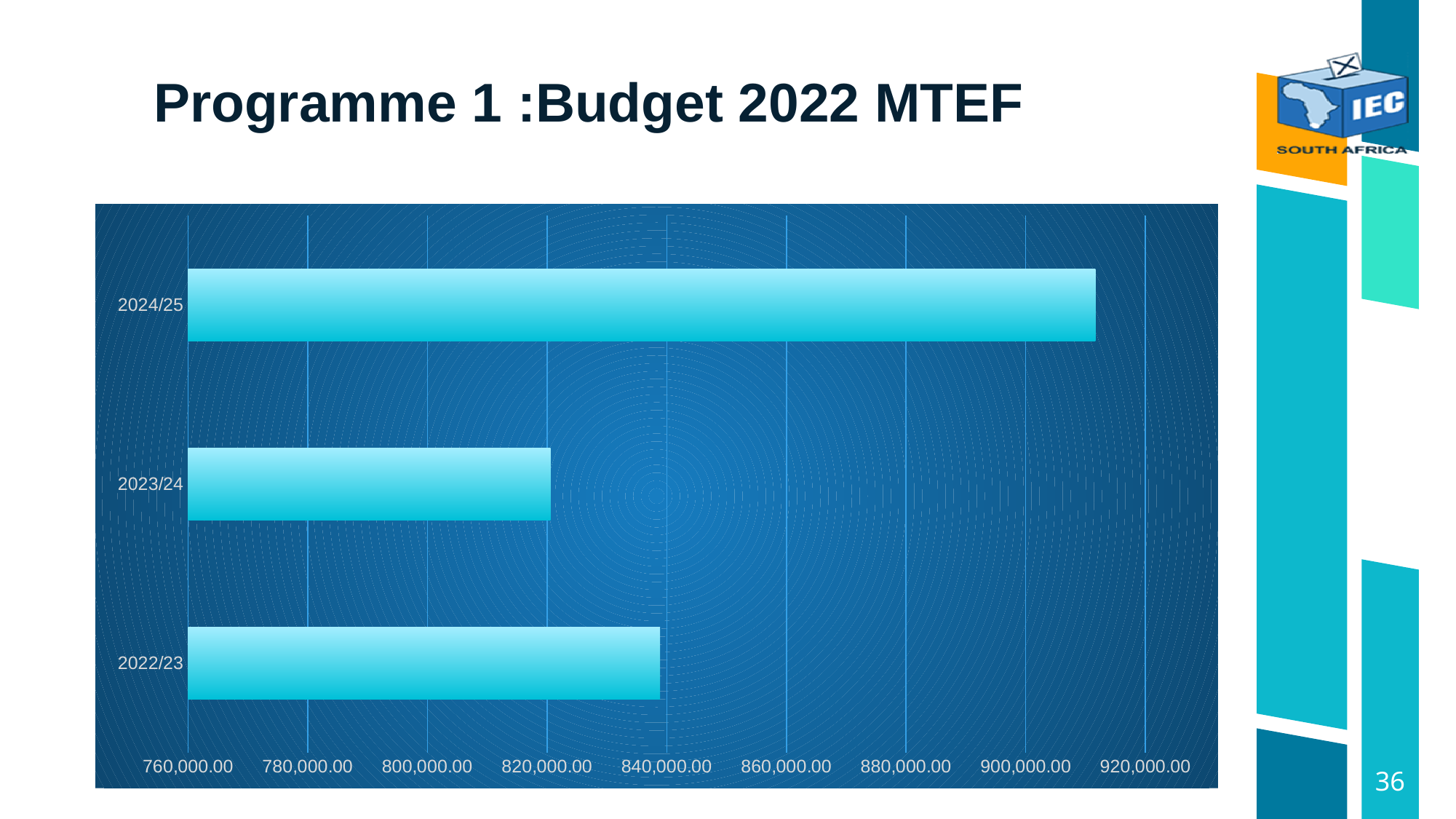
Which has the larger budget value, 2024/25 or 2022/23? 2024/25 Which financial year has the highest budget value in the chart? 2024/25 What kind of chart is shown on the slide? bar chart What is the title of the slide containing the chart? Programme 1 :Budget 2022 MTEF Is the value for 2022/23 greater or less than 820,000.00? greater Is the value for 2024/25 greater or less than 900,000.00? greater What is the lowest value shown on the chart's horizontal axis? 760,000.00 Is the value for 2024/25 greater or less than 920,000.00? less Which has the larger budget value, 2022/23 or 2023/24? 2022/23 Which financial year has the lowest budget value in the chart? 2023/24 How many financial years are plotted in the chart? 3